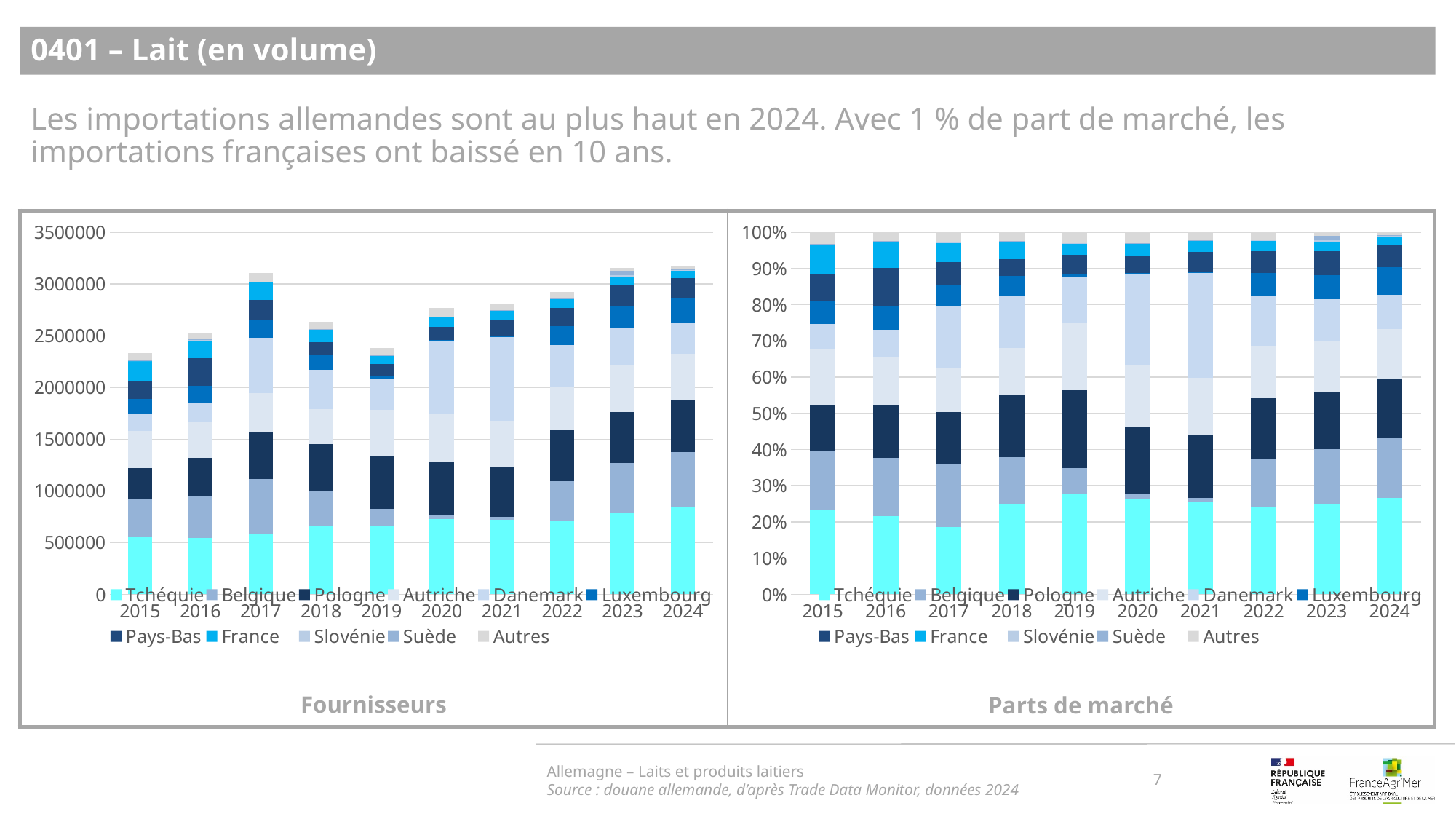
What kind of chart is the 'Fournisseurs' chart on the left? stacked bar chart In the 'Fournisseurs' chart, is the total stacked value for 2019 greater or less than 2500000? less In the 'Fournisseurs' chart, is the total stacked value for 2024 greater or less than 3000000? greater In the 'Fournisseurs' chart, do the total stacked values rise or fall from 2019 to 2024? rise How many series does the legend of the 'Parts de marché' chart list? 11 How many years are shown on the x axis of the 'Fournisseurs' chart? 10 Which series is listed first in the legend of the 'Fournisseurs' chart? Tchéquie In the 'Fournisseurs' chart, which year has the larger total stacked value, 2017 or 2018? 2017 In the 'Parts de marché' chart, is the Tchéquie share for 2024 greater or less than 20%? greater What is the title of the chart on the right of the slide? Parts de marché In the 'Fournisseurs' chart, which year has the larger total stacked value, 2019 or 2022? 2022